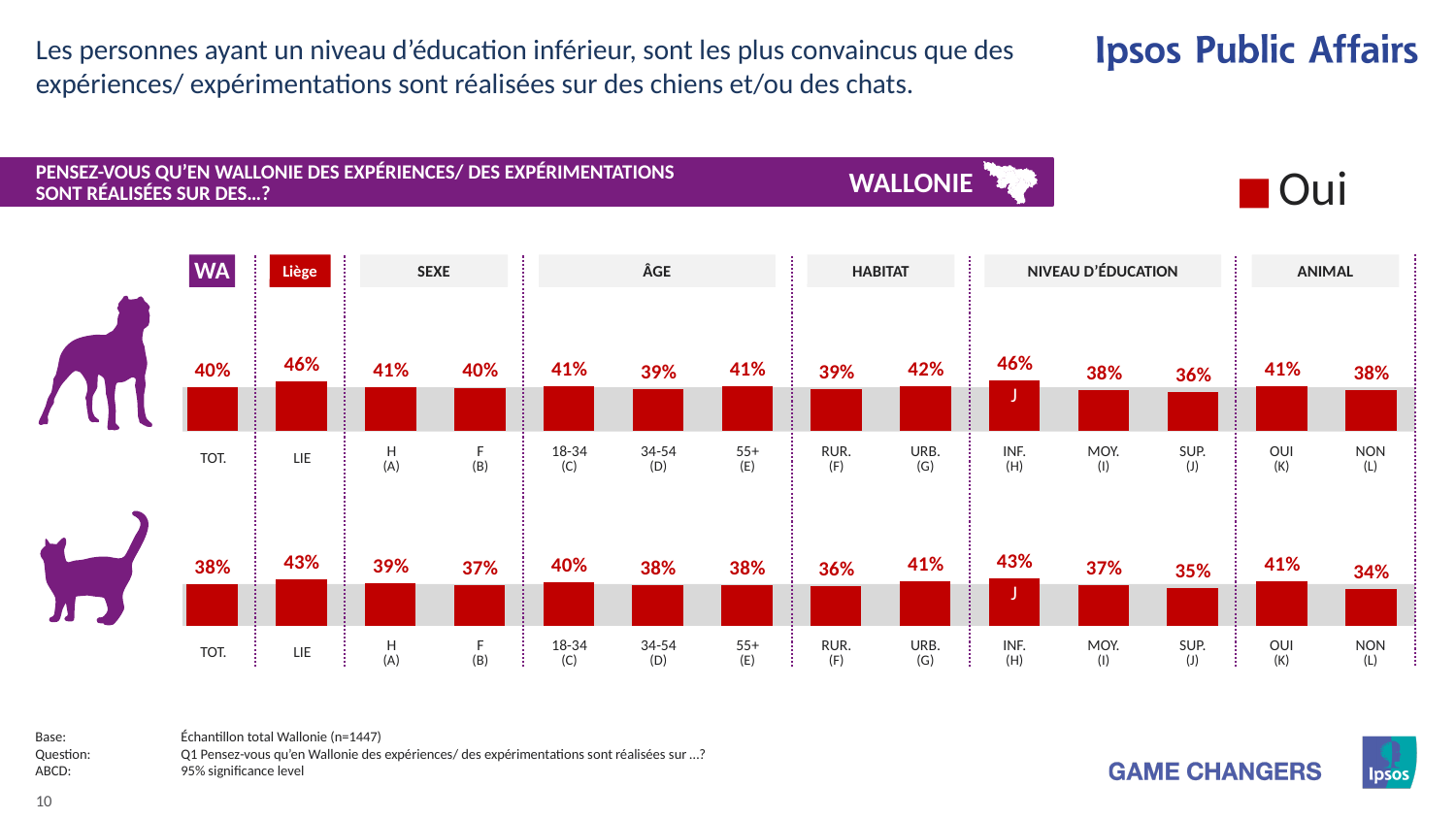
In the bottom (cat) chart, which is larger, the value for H (A) or F (B)? H (A) In the top (dog) chart, which education level (INF., MOY., SUP.) has the highest value? INF. In the top (dog) chart, which is larger, the value for OUI (K) or NON (L)? OUI (K) In the bottom (cat) chart, what is the value for NON (L) under Animal? 34% In the bottom (cat) chart, what is the difference between URB. (G) and RUR. (F)? 5 percentage points In the top (dog) chart, what is the value for Liège (LIE)? 46% What kind of chart is used on this slide? Bar chart In the top (dog) chart, what is the value for TOT.? 40% In the bottom (cat) chart, what is the value for SUP. (J) under Niveau d'éducation? 35% How many series does the legend list? 1 In the top (dog) chart, what is the difference between INF. (H) and SUP. (J)? 10 percentage points In the bottom (cat) chart, which category has the lowest value? NON (L)